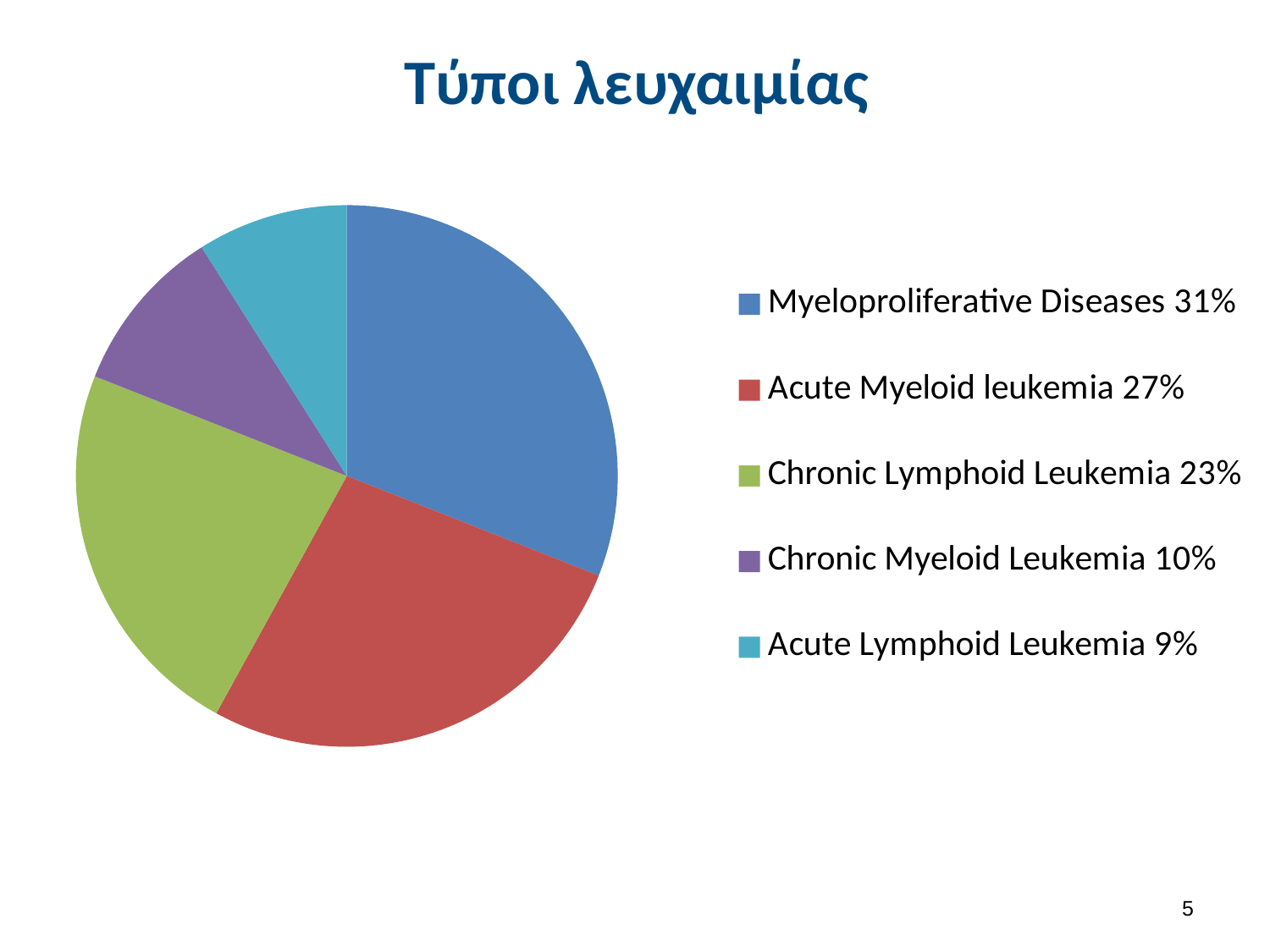
Which is larger, the share for Acute Myeloid leukemia or the share for Chronic Lymphoid Leukemia? Acute Myeloid leukemia What is the difference in percentage points between Myeloproliferative Diseases and Chronic Myeloid Leukemia? 21 What kind of chart is shown on the slide? pie chart Which category has the smallest share of the pie? Acute Lymphoid Leukemia What percentage is shown for Acute Myeloid leukemia? 27% What colour is the slice for Chronic Lymphoid Leukemia? green What percentage is shown for Acute Lymphoid Leukemia? 9% What is the title of the slide containing the pie chart? Τύποι λευχαιμίας Which category has the largest share of the pie? Myeloproliferative Diseases How many slices does the pie chart have? 5 What percentage is shown for Chronic Lymphoid Leukemia? 23% What percentage is shown for Myeloproliferative Diseases? 31%